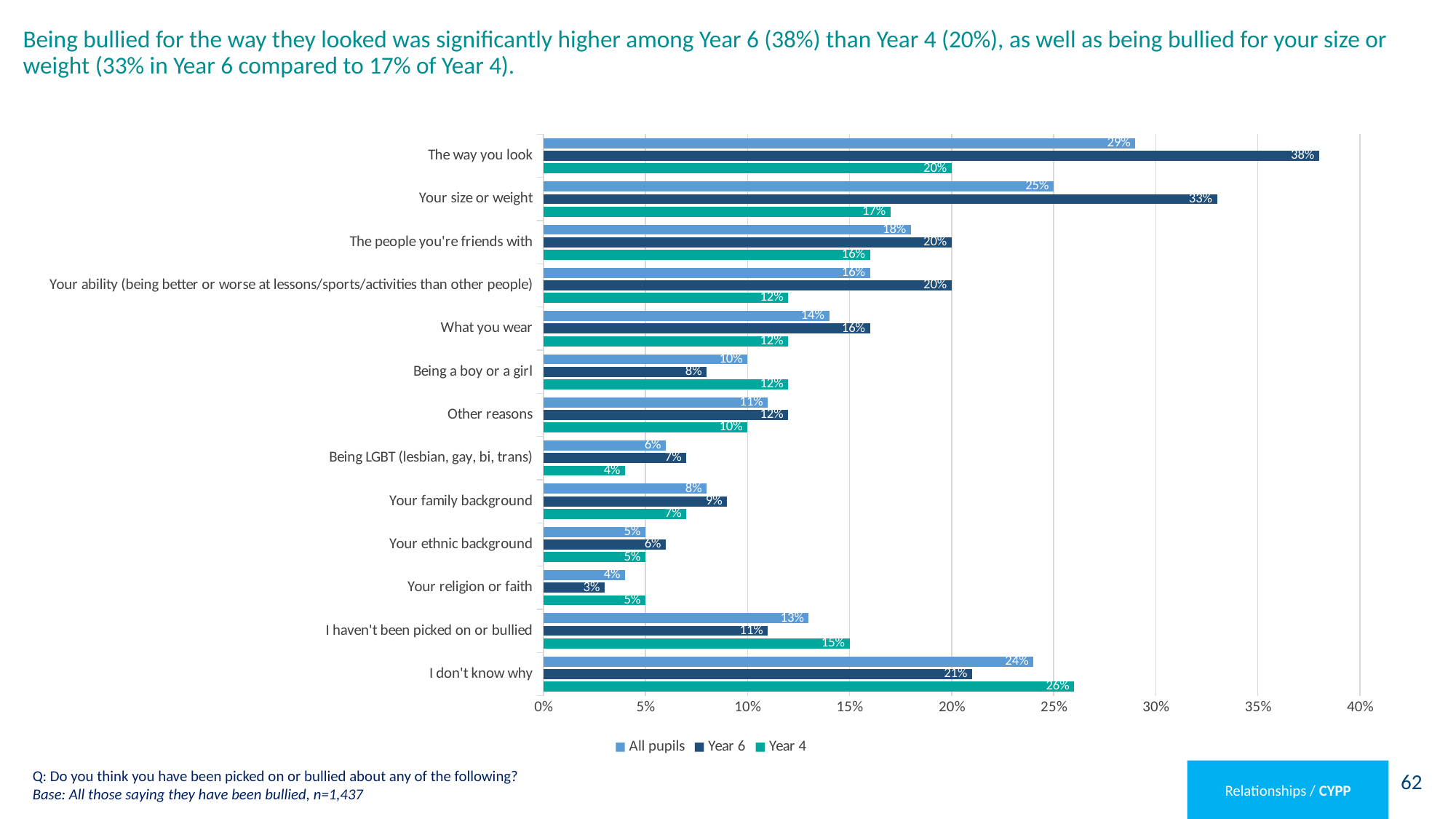
What is the All pupils value for 'I don't know why'? 24% What kind of chart is shown on the slide? Bar chart What is the difference between the Year 6 and Year 4 values for 'Your size or weight'? 16% Is the Year 4 value for 'I don't know why' greater or less than 25%? greater Which category has the highest Year 6 value? The way you look For 'Being a boy or a girl', which is larger: the Year 6 value or the Year 4 value? Year 4 How many series does the legend list? 3 What is the Year 4 value for 'Your size or weight'? 17% Which category has the lowest Year 6 value? Your religion or faith What is the Year 6 value for 'The way you look'? 38% What are the three series listed in the legend? All pupils, Year 6, Year 4 How many categories are shown on the chart? 13